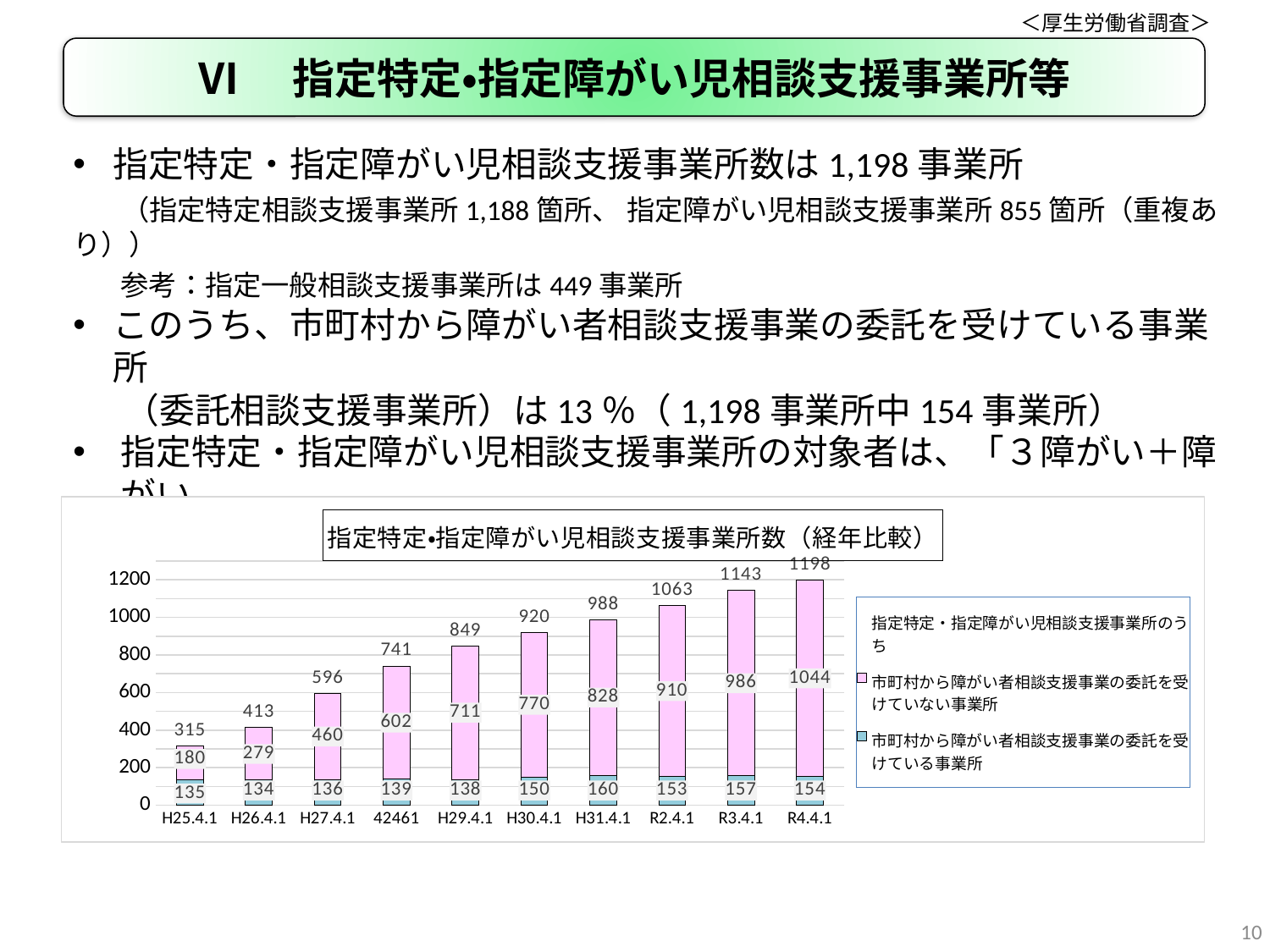
Do the total values rise or fall from H25.4.1 to R4.4.1? rise What is the value for 市町村から障がい者相談支援事業の委託を受けていない事業所 at H29.4.1? 711 What is the difference between the total for R4.4.1 and the total for R3.4.1? 55 Which is larger: the value for 市町村から障がい者相談支援事業の委託を受けていない事業所 at H27.4.1 or at H30.4.1? H30.4.1 Which category has the highest total value? R4.4.1 What is the total value of the stacked bar for R4.4.1? 1198 What type of chart is shown on the slide? stacked bar chart What is the title of the chart? 指定特定•指定障がい児相談支援事業所数（経年比較） What is the value for 市町村から障がい者相談支援事業の委託を受けている事業所 at H31.4.1? 160 How many categories are shown on the x axis of the chart? 10 Which category has the lowest total value? H25.4.1